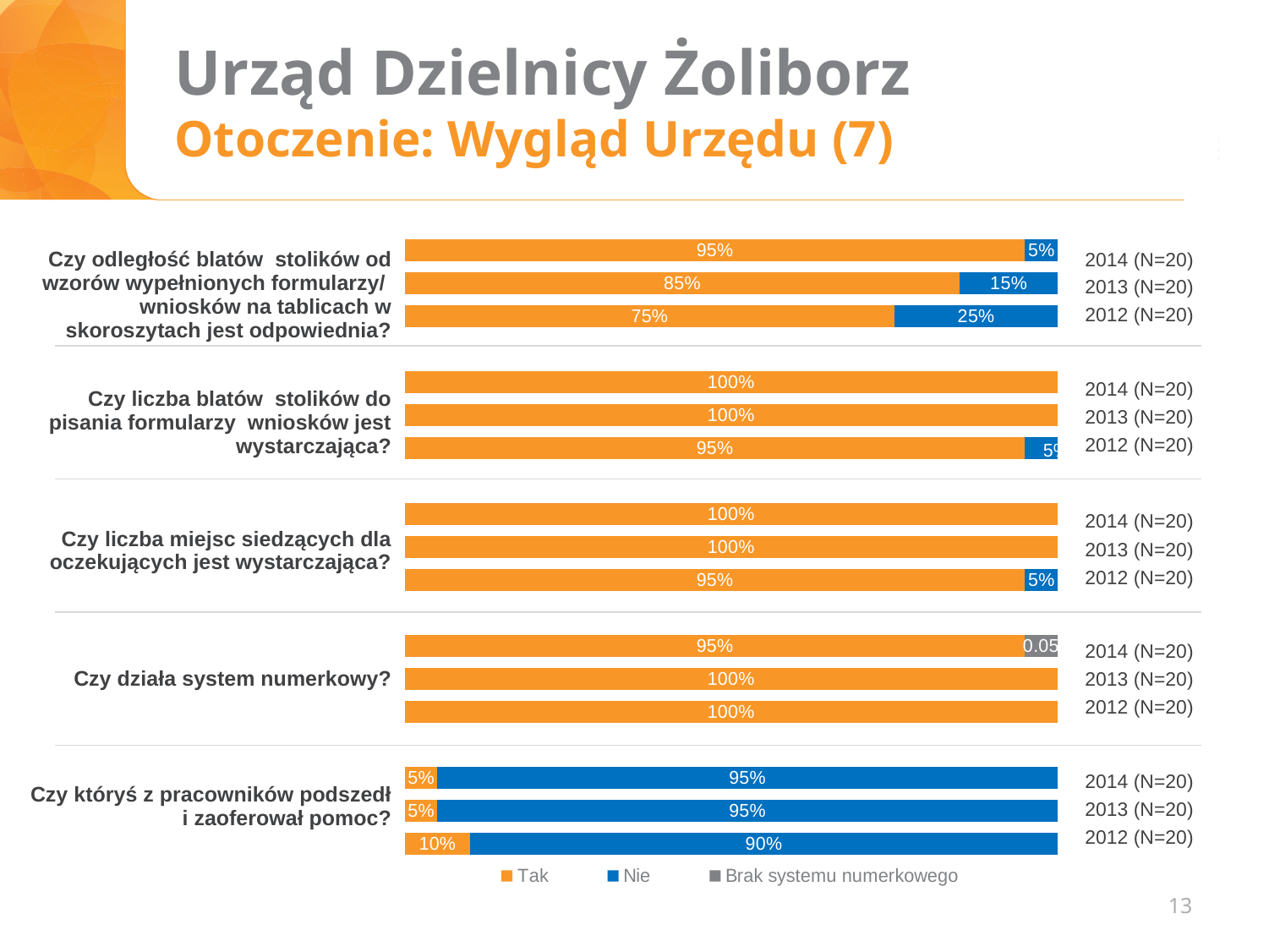
In the chart for "Czy któryś z pracowników podszedł i zaoferował pomoc?", what is the Nie value for 2012 (N=20)? 90% In the chart for "Czy liczba blatów stolików do pisania formularzy wniosków jest wystarczająca?", what is the Tak value for 2013 (N=20)? 100% In the chart for "Czy liczba miejsc siedzących dla oczekujących jest wystarczająca?", what is the Nie value for 2012 (N=20)? 5% What kind of chart is used on this slide? bar chart In the chart for "Czy odległość blatów stolików od wzorów wypełnionych formularzy/wniosków na tablicach w skoroszytach jest odpowiednia?", which year has the lowest Tak value? 2012 (N=20) In the chart for "Czy odległość blatów stolików od wzorów wypełnionych formularzy/wniosków na tablicach w skoroszytach jest odpowiednia?", does the Tak value rise or fall from 2012 to 2014? rise In the chart for "Czy odległość blatów stolików od wzorów wypełnionych formularzy/wniosków na tablicach w skoroszytach jest odpowiednia?", what is the value for Tak in 2014 (N=20)? 95% In the chart for "Czy odległość blatów stolików od wzorów wypełnionych formularzy/wniosków na tablicach w skoroszytach jest odpowiednia?", what is the value for Nie in 2012 (N=20)? 25% In the chart for "Czy odległość blatów stolików od wzorów wypełnionych formularzy/wniosków na tablicach w skoroszytach jest odpowiednia?", what is the difference between the Tak values for 2014 and 2012? 20% In the chart for "Czy działa system numerkowy?", what is the Tak value for 2014 (N=20)? 95% In the chart for "Czy któryś z pracowników podszedł i zaoferował pomoc?", which is larger in 2014 (N=20): Tak or Nie? Nie How many series does the legend at the bottom of the slide list? 3